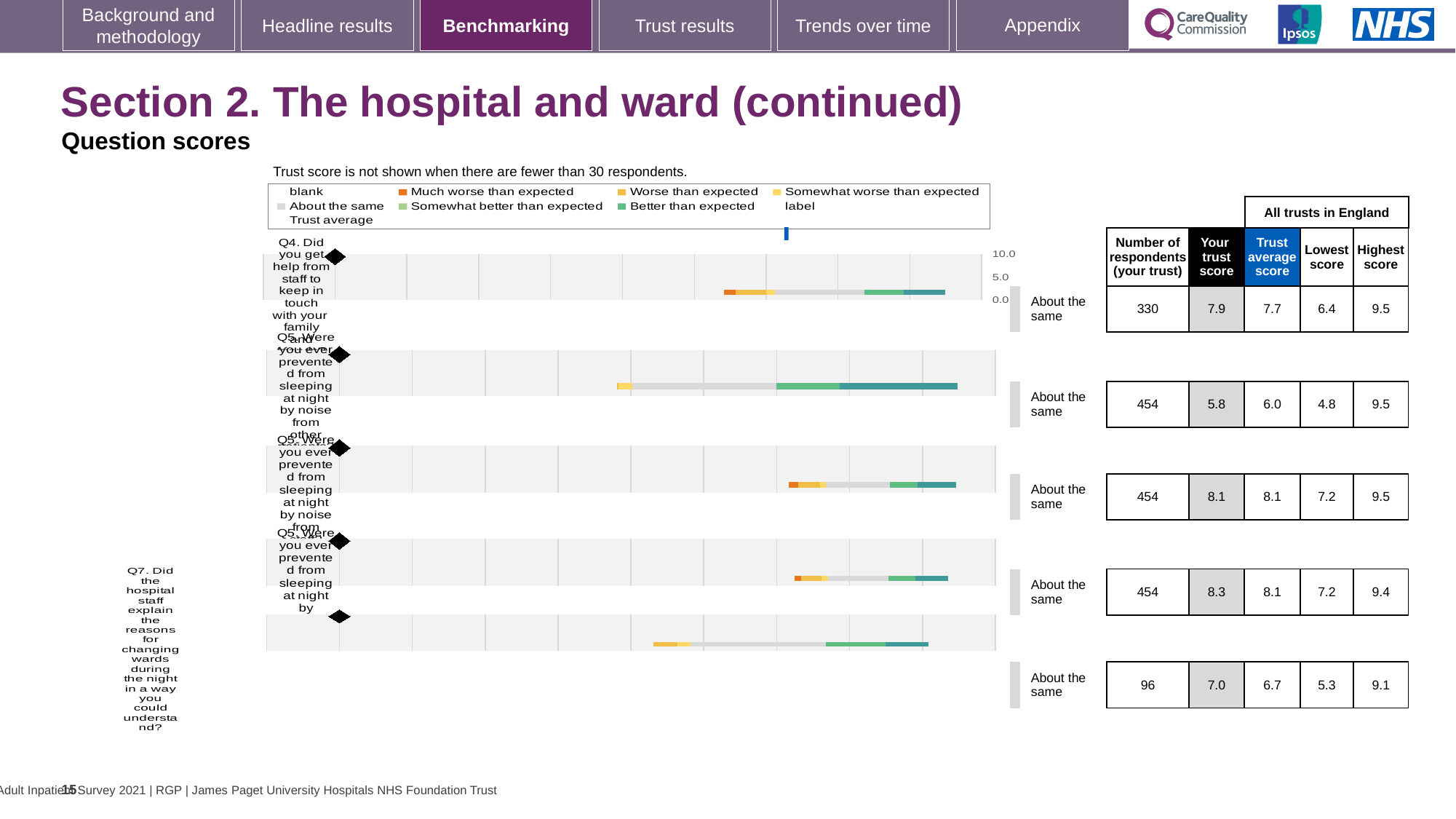
For the second question row, which is larger: 'Your trust score' or 'Trust average score'? Trust average score What kind of chart is shown on the slide? bar chart In the table beside the chart, what is the 'Trust average score' for the second question row? 6.0 Which question row has the lowest 'Your trust score' in the table? the second row (5.8) How many question rows (bars) are plotted in the chart? 5 Which question row has the highest 'Your trust score' in the table? the fourth row (8.3) For the first (top) question row, Q4, what is the difference between 'Your trust score' and 'Trust average score'? 0.2 What is the 'Highest score' for the last (bottom) question row, Q7, in the table? 9.1 What is the maximum value shown on the chart's score axis? 10.0 What benchmark category is shown next to every question row in the chart? About the same In the table beside the chart, what is the number of respondents for the last (bottom) question row, Q7? 96 In the table beside the chart, what is the 'Your trust score' for the first (top) question row, Q4? 7.9